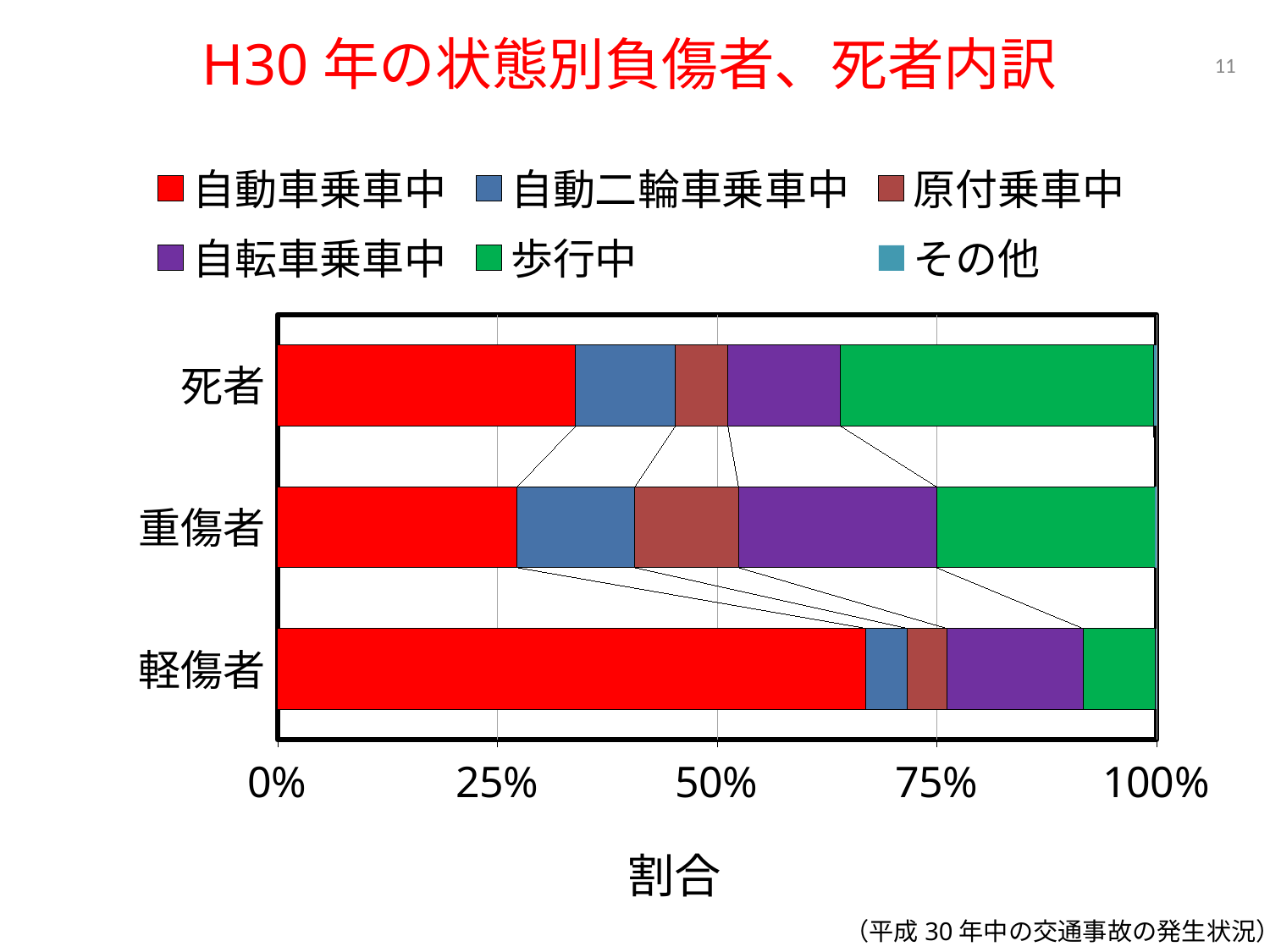
Is the 自動車乗車中 share of the 死者 bar greater or less than 50%? less What kind of chart is shown on the slide? Stacked bar chart What is the title of the chart on the slide? H30年の状態別負傷者、死者内訳 How many series does the legend list? 6 Is the 歩行中 share of the 死者 bar greater or less than 25%? greater Which category has the largest 歩行中 share: 死者, 重傷者 or 軽傷者? 死者 What is the label of the horizontal axis? 割合 Is the 歩行中 share of the 軽傷者 bar greater or less than 25%? less Which category has the largest 自動車乗車中 share: 死者, 重傷者 or 軽傷者? 軽傷者 How many categories (bars) are plotted on the chart? 3 Which has the larger 自転車乗車中 share, 死者 or 重傷者? 重傷者